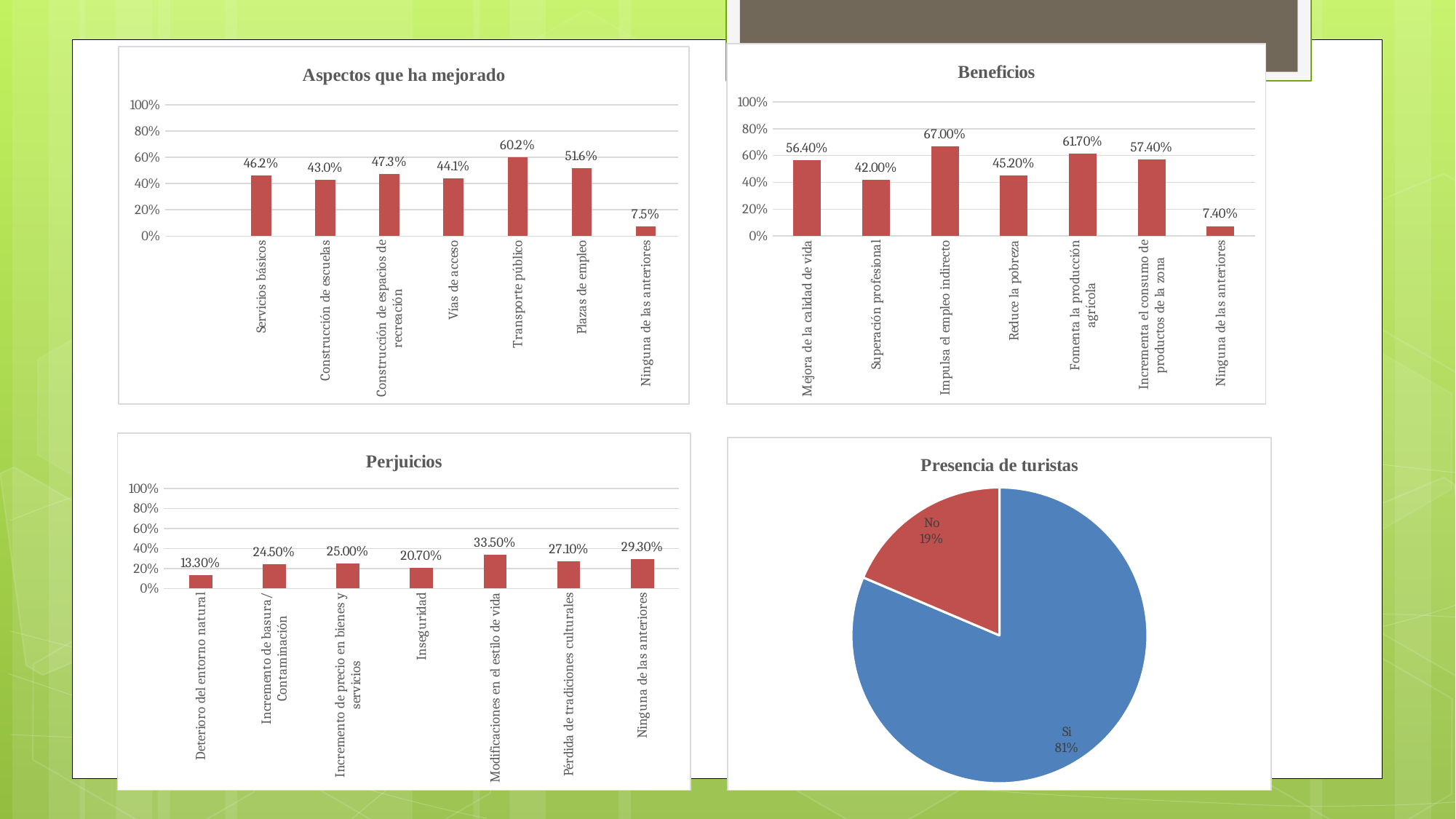
In the 'Beneficios' chart, what is the difference between Fomenta la producción agrícola and Superación profesional? 19.70% What kind of chart is 'Presencia de turistas'? Pie chart In the 'Beneficios' chart, which is larger: Mejora de la calidad de vida or Reduce la pobreza? Mejora de la calidad de vida In the 'Beneficios' chart, which category has the highest value? Impulsa el empleo indirecto In the 'Aspectos que ha mejorado' chart, which category has the lowest value? Ninguna de las anteriores In the 'Presencia de turistas' chart, what share of the pie is 'Si'? 81% In the 'Aspectos que ha mejorado' chart, what is the value for Transporte público? 60.2% In the 'Perjuicios' chart, what is the difference between Ninguna de las anteriores and Deterioro del entorno natural? 16.00% In the 'Perjuicios' chart, which category has the highest value? Modificaciones en el estilo de vida In the 'Beneficios' chart, what is the value for Impulsa el empleo indirecto? 67.00% In the 'Aspectos que ha mejorado' chart, how many categories are shown? 7 In the 'Perjuicios' chart, what is the value for Inseguridad? 20.70%